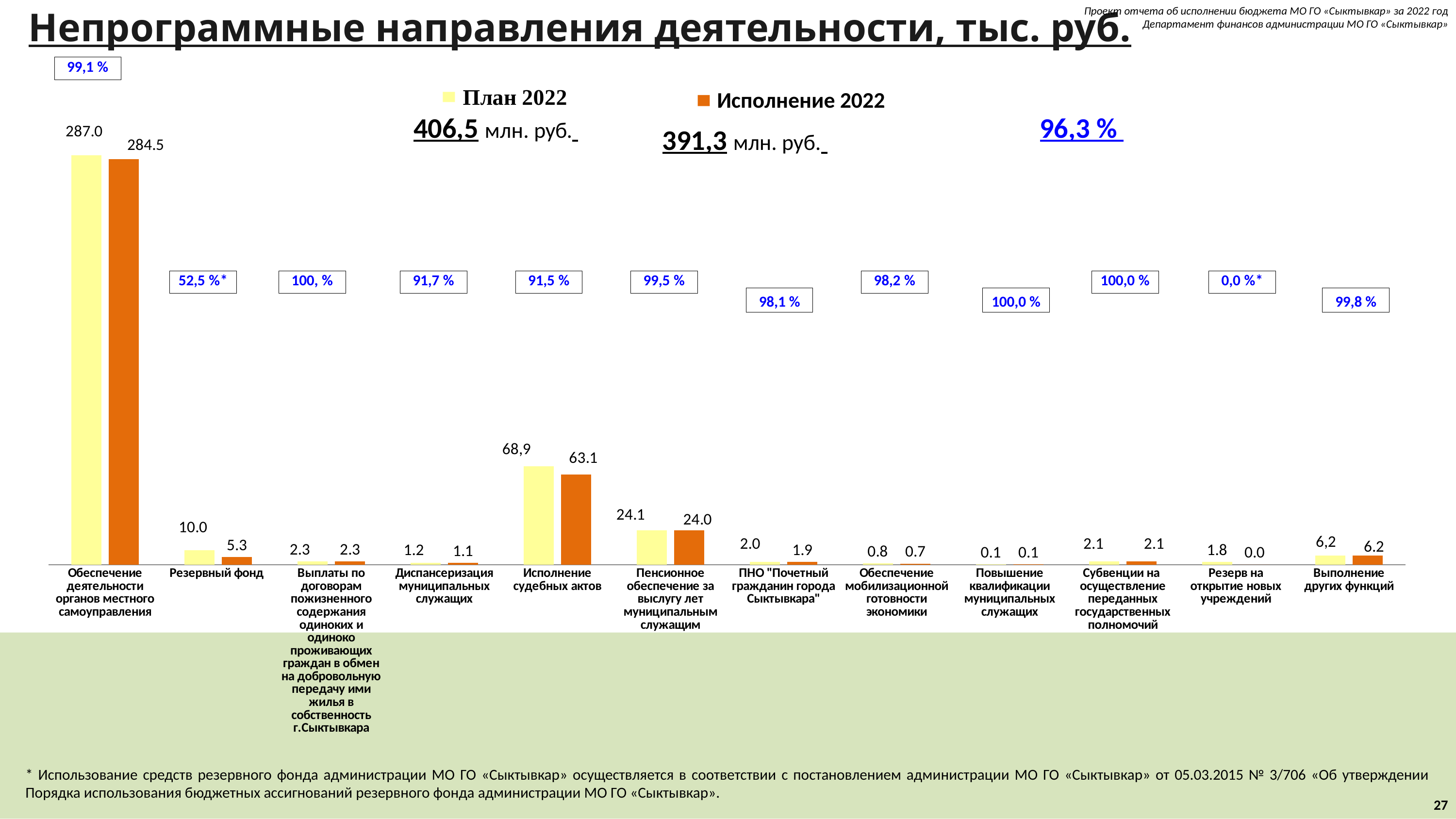
How many series does the chart legend list? 2 How many categories are shown on the x axis of the chart? 12 What is the Исполнение 2022 value for Резерв на открытие новых учреждений? 0.0 What is the Исполнение 2022 value for Исполнение судебных актов? 63.1 What is the difference between the План 2022 and Исполнение 2022 values for Резервный фонд? 4.7 What total Исполнение 2022 amount in млн. руб. is shown next to the legend? 391,3 млн. руб. Which category has the highest План 2022 value? Обеспечение деятельности органов местного самоуправления Which category has the lowest Исполнение 2022 value? Резерв на открытие новых учреждений Which is larger: the Исполнение 2022 value for Исполнение судебных актов or for Пенсионное обеспечение за выслугу лет муниципальным служащим? Исполнение судебных актов What is the План 2022 value for Резервный фонд? 10.0 What kind of chart is shown on the slide? bar chart What is the difference between the План 2022 and Исполнение 2022 values for Обеспечение деятельности органов местного самоуправления? 2.5